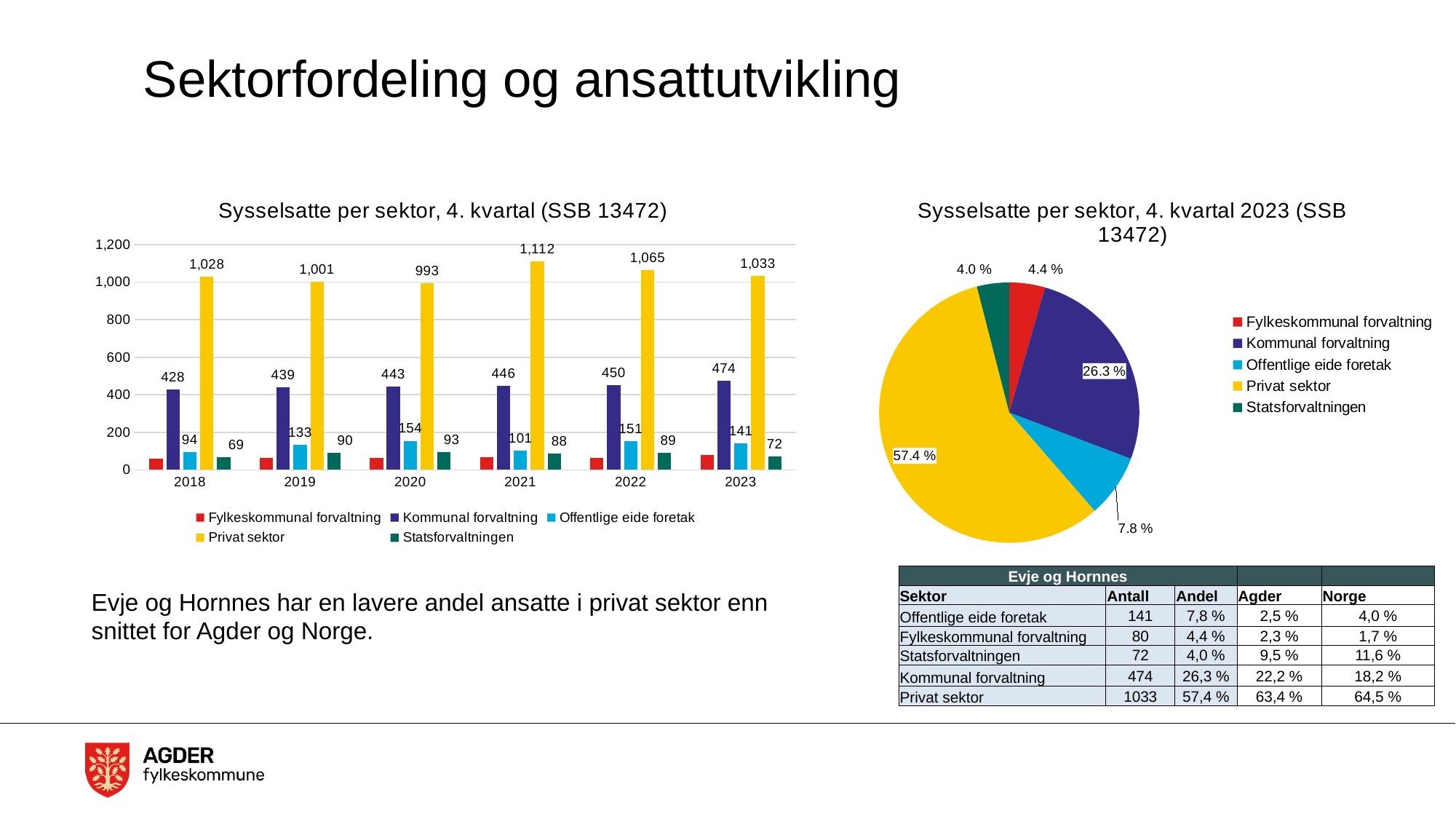
In the left bar chart, does the Kommunal forvaltning value rise or fall from 2018 to 2023? rise In the left bar chart, what is the difference between the Privat sektor values for 2021 and 2020? 119 In the pie chart 'Sysselsatte per sektor, 4. kvartal 2023 (SSB 13472)', what share does Privat sektor have? 57.4 % In the left bar chart 'Sysselsatte per sektor, 4. kvartal (SSB 13472)', what is the value for Privat sektor in 2021? 1,112 In the left bar chart, what is the value for Kommunal forvaltning in 2023? 474 In the left bar chart, in which year is the Statsforvaltningen value lowest? 2018 In the left bar chart, how many series does the legend list? 5 In the left bar chart, is the value for Fylkeskommunal forvaltning in 2023 greater or less than 200? less In the left bar chart, in which year is the Privat sektor value highest? 2021 In the left bar chart, how many years are shown on the x axis? 6 What kind of chart is the left chart 'Sysselsatte per sektor, 4. kvartal (SSB 13472)'? bar chart In the pie chart on the right, which sector has the largest slice? Privat sektor